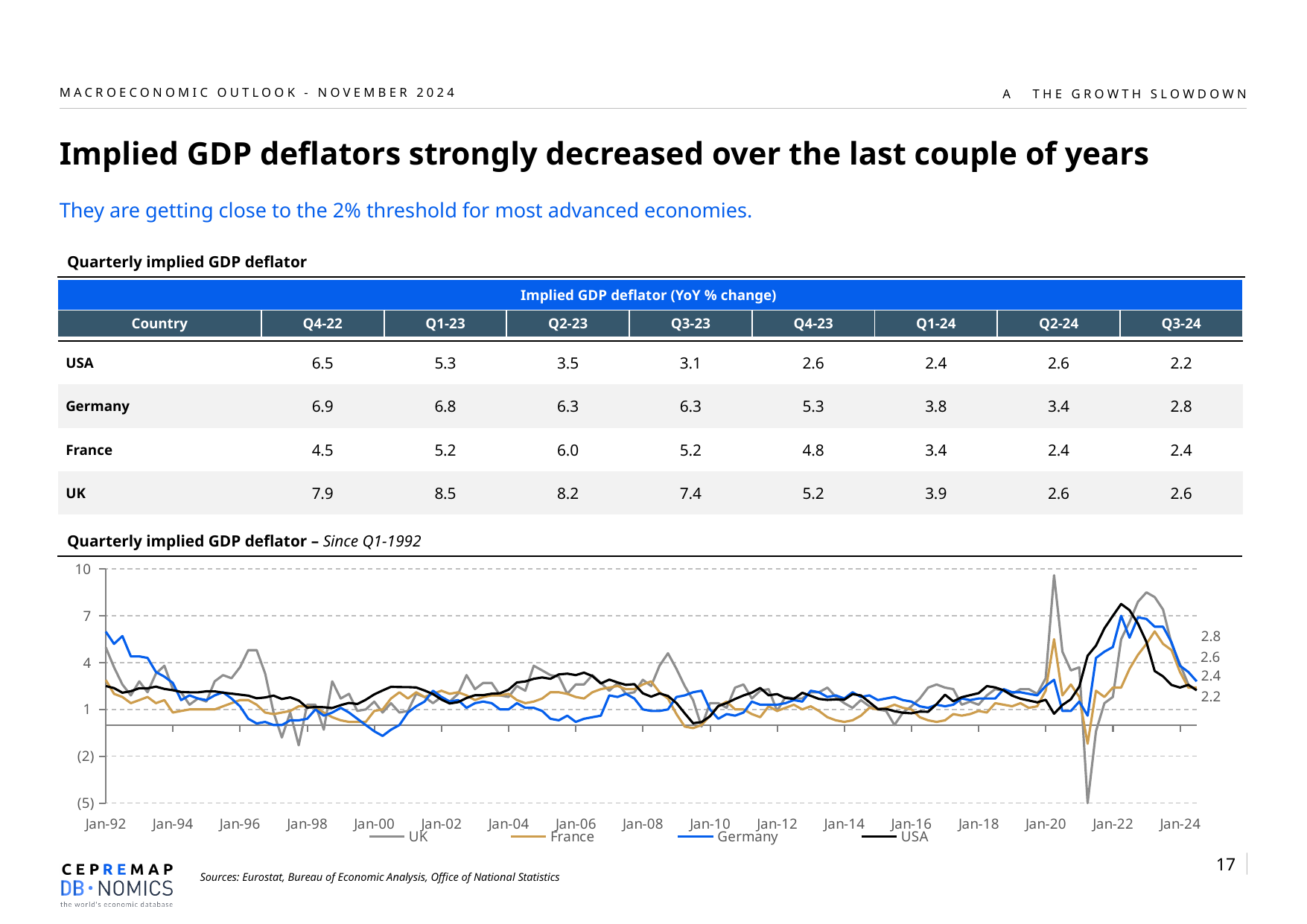
Which countries are listed in the legend of the line chart? UK, France, Germany, USA How many year labels are shown on the x axis of the line chart? 17 Which series falls to the lowest value anywhere on the line chart? UK At the right end of the line chart, which series is higher, Germany or USA? Germany In the line chart, what is the latest value labelled at the end of the USA series? 2.2 How many series does the legend of the line chart list? 4 In the line chart, what is the difference between the latest labelled values for Germany (2.8) and the USA (2.2)? 0.6 In the line chart, is the UK peak around Jan-20 greater or less than 7? greater What kind of chart is shown under the heading 'Quarterly implied GDP deflator – Since Q1-1992'? Line chart In the line chart, what is the latest value labelled at the end of the Germany series? 2.8 Which series reaches the highest peak anywhere on the line chart? UK